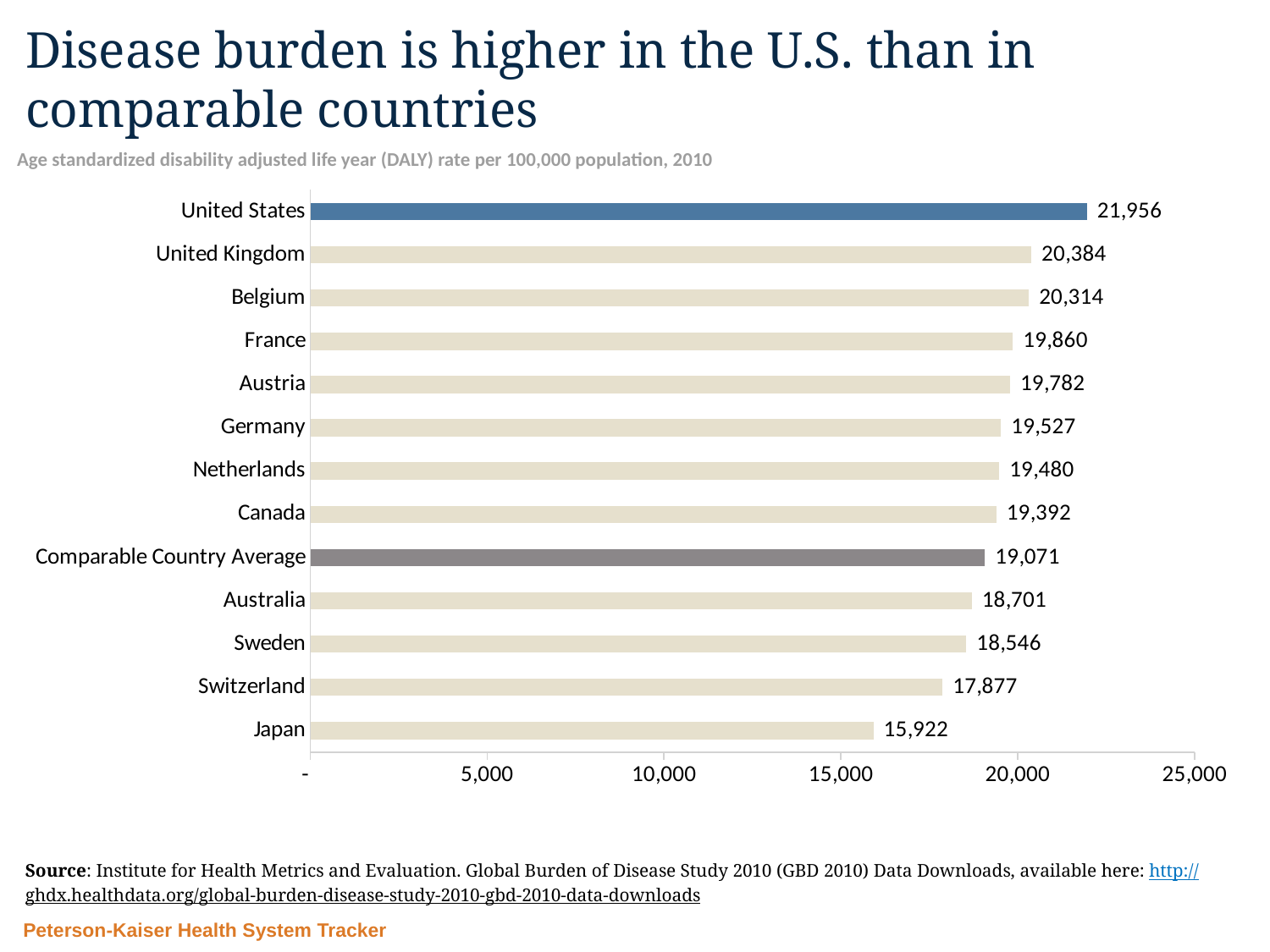
How many bars are shown on the chart? 13 What is the value shown for the Comparable Country Average? 19,071 What is the DALY rate per 100,000 population for the United States? 21,956 What kind of chart is shown on the slide? bar chart Which country has the lowest DALY rate on the chart? Japan Which has a higher DALY rate, Sweden or Australia? Australia What is the value shown for Japan? 15,922 What is the title of the slide? Disease burden is higher in the U.S. than in comparable countries What is the difference between the United States value and the Comparable Country Average? 2,885 Is the value for Switzerland greater or less than 20,000? less Which country has the highest DALY rate on the chart? United States What is the difference between the United Kingdom and Belgium values? 70